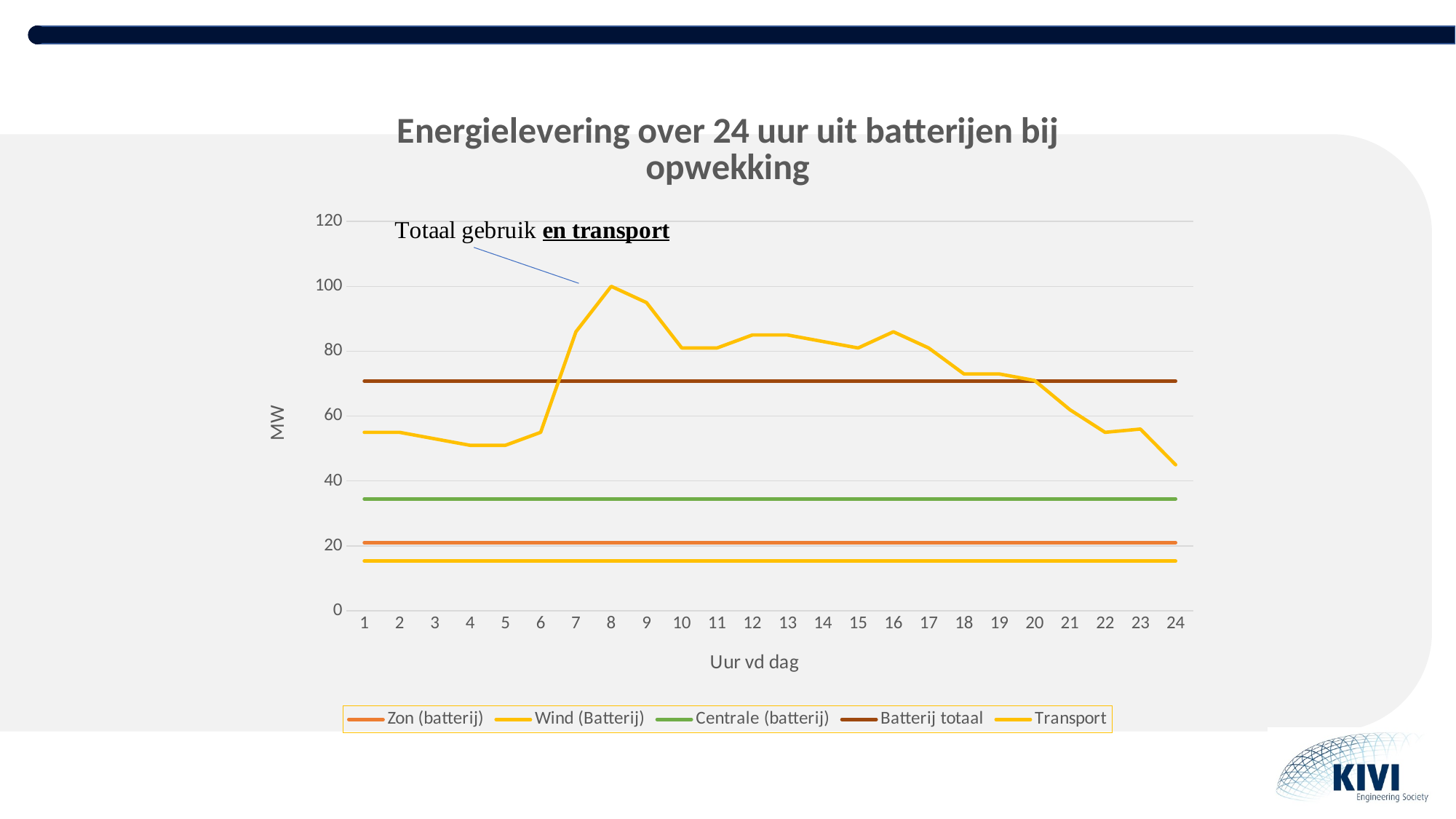
How many hours are plotted along the x axis? 24 What is the value of the Transport line at hour 8? 100 Is the value of the Transport line at hour 24 greater or less than 60? less Is the value of the Centrale (batterij) line greater or less than 40? less What unit is shown on the y axis? MW How many series does the legend list? 5 What kind of chart is shown on the slide? line chart At which hour does the Transport line reach its highest value? 8 Does the Transport line rise or fall from hour 16 to hour 24? fall Is the value of the Batterij totaal line greater or less than 60? greater What is the label of the x axis? Uur vd dag Which line is higher, Batterij totaal or Centrale (batterij)? Batterij totaal